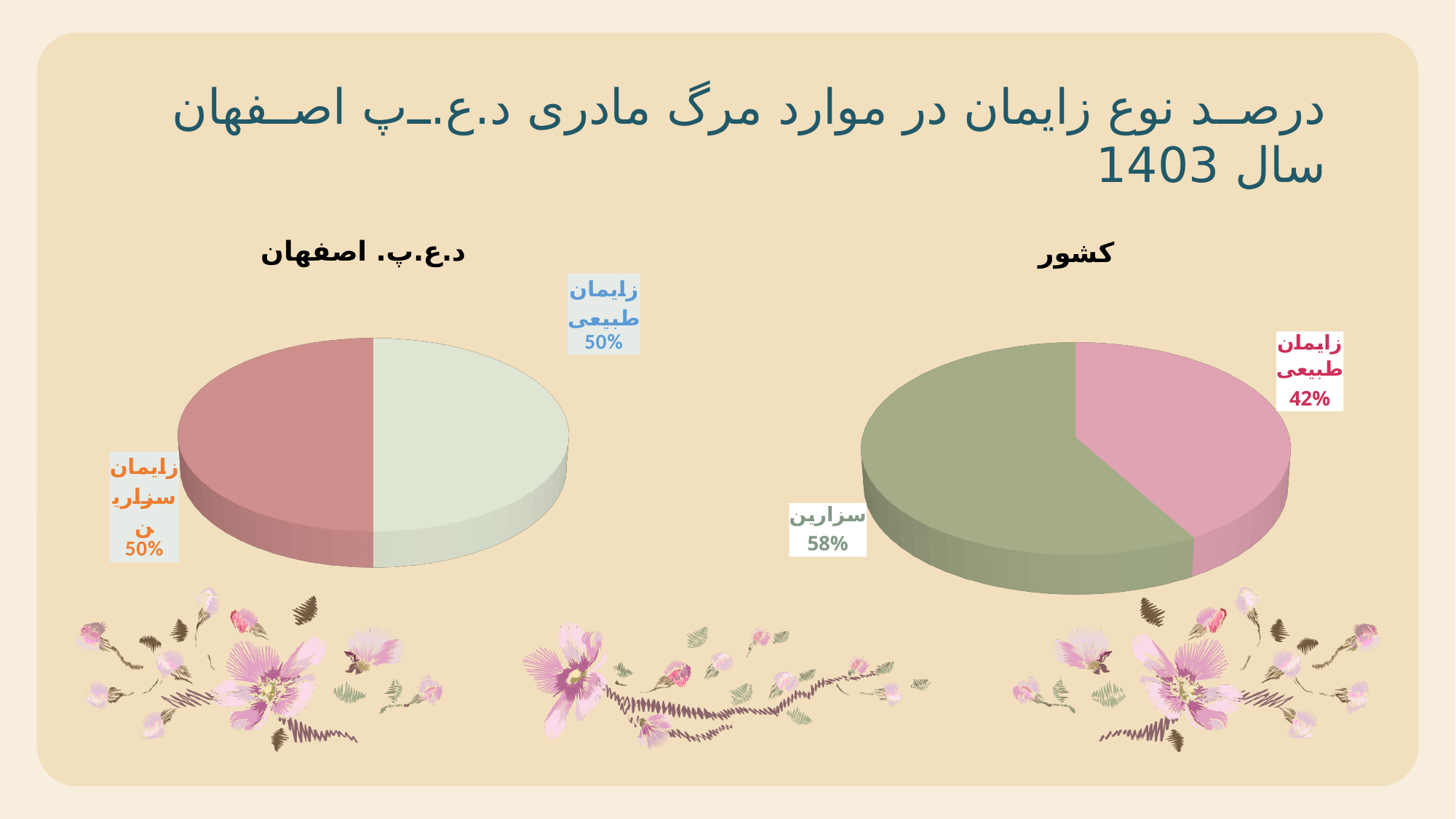
In the chart titled "د.ع.پ. اصفهان", what is the value for زایمان سزارین? 50% In the chart titled "کشور", which category has the smallest slice? زایمان طبیعی How many pie charts are shown on the slide? 2 In the chart titled "کشور", which category has the largest slice? سزارین In the chart titled "د.ع.پ. اصفهان", what is the value for زایمان طبیعی? 50% In the chart titled "کشور", what is the difference between the سزارین and زایمان طبیعی values? 16% In the chart titled "کشور", what is the value for سزارین? 58% How many slices does the chart titled "کشور" have? 2 In the chart titled "کشور", what is the value for زایمان طبیعی? 42% In the chart titled "کشور", which is larger, سزارین or زایمان طبیعی? سزارین What kind of chart is the chart titled "د.ع.پ. اصفهان"? pie chart What is the title of the chart on the right side of the slide? کشور